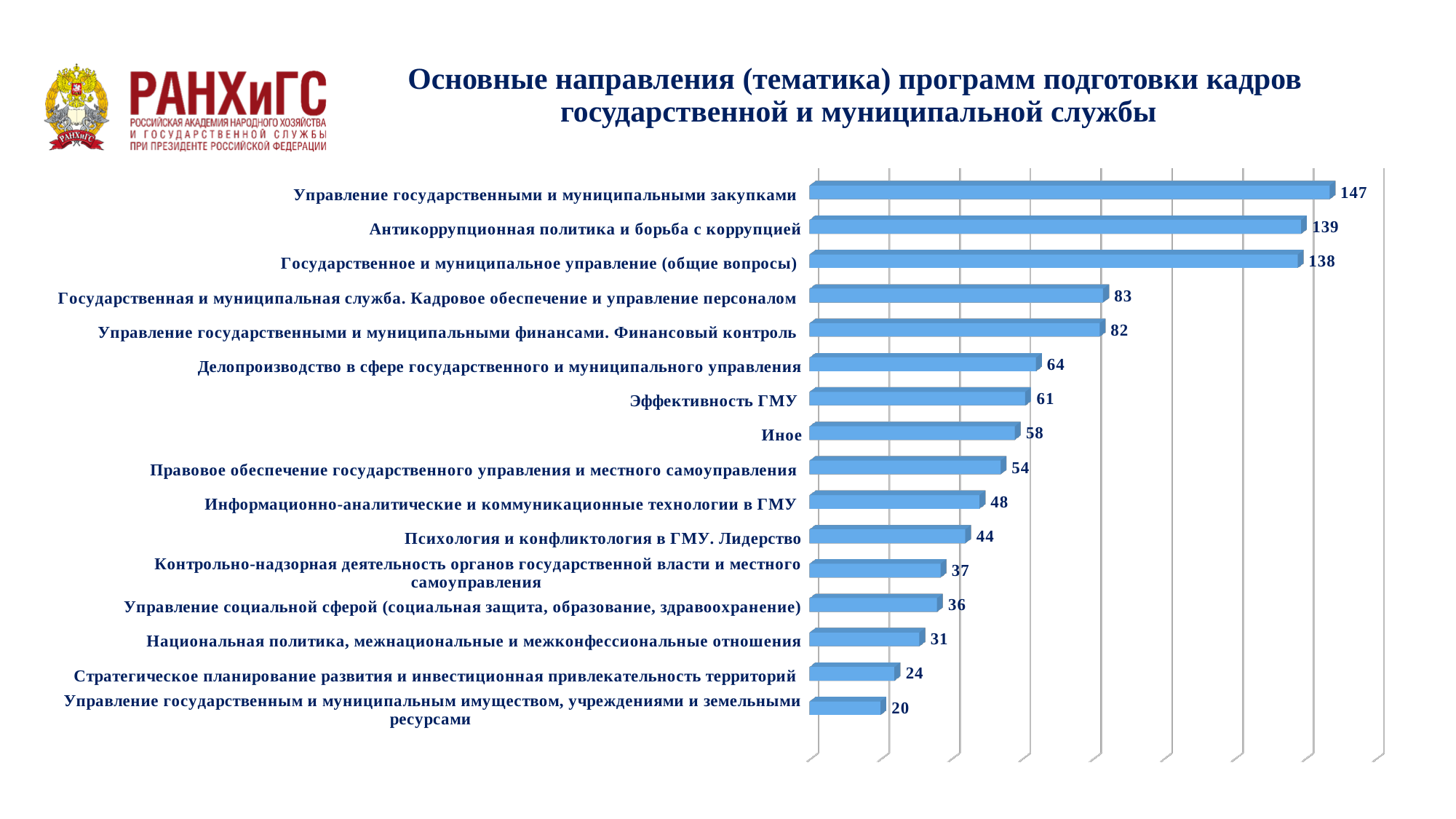
Which is larger: the value for «Информационно-аналитические и коммуникационные технологии в ГМУ» or for «Национальная политика, межнациональные и межконфессиональные отношения»? Информационно-аналитические и коммуникационные технологии в ГМУ Which category has the lowest value? Управление государственным и муниципальным имуществом, учреждениями и земельными ресурсами What value is shown for «Стратегическое планирование развития и инвестиционная привлекательность территорий»? 24 What is the difference between the values for «Делопроизводство в сфере государственного и муниципального управления» and «Иное»? 6 Which category has the highest value? Управление государственными и муниципальными закупками What value is shown for «Эффективность ГМУ»? 61 What is the title of the slide? Основные направления (тематика) программ подготовки кадров государственной и муниципальной службы How many categories are shown in the chart? 16 What value is shown for «Психология и конфликтология в ГМУ. Лидерство»? 44 What is the difference between the values for «Управление государственными и муниципальными закупками» and «Антикоррупционная политика и борьба с коррупцией»? 8 What kind of chart is shown on the slide? Bar chart What value is shown for «Антикоррупционная политика и борьба с коррупцией»? 139